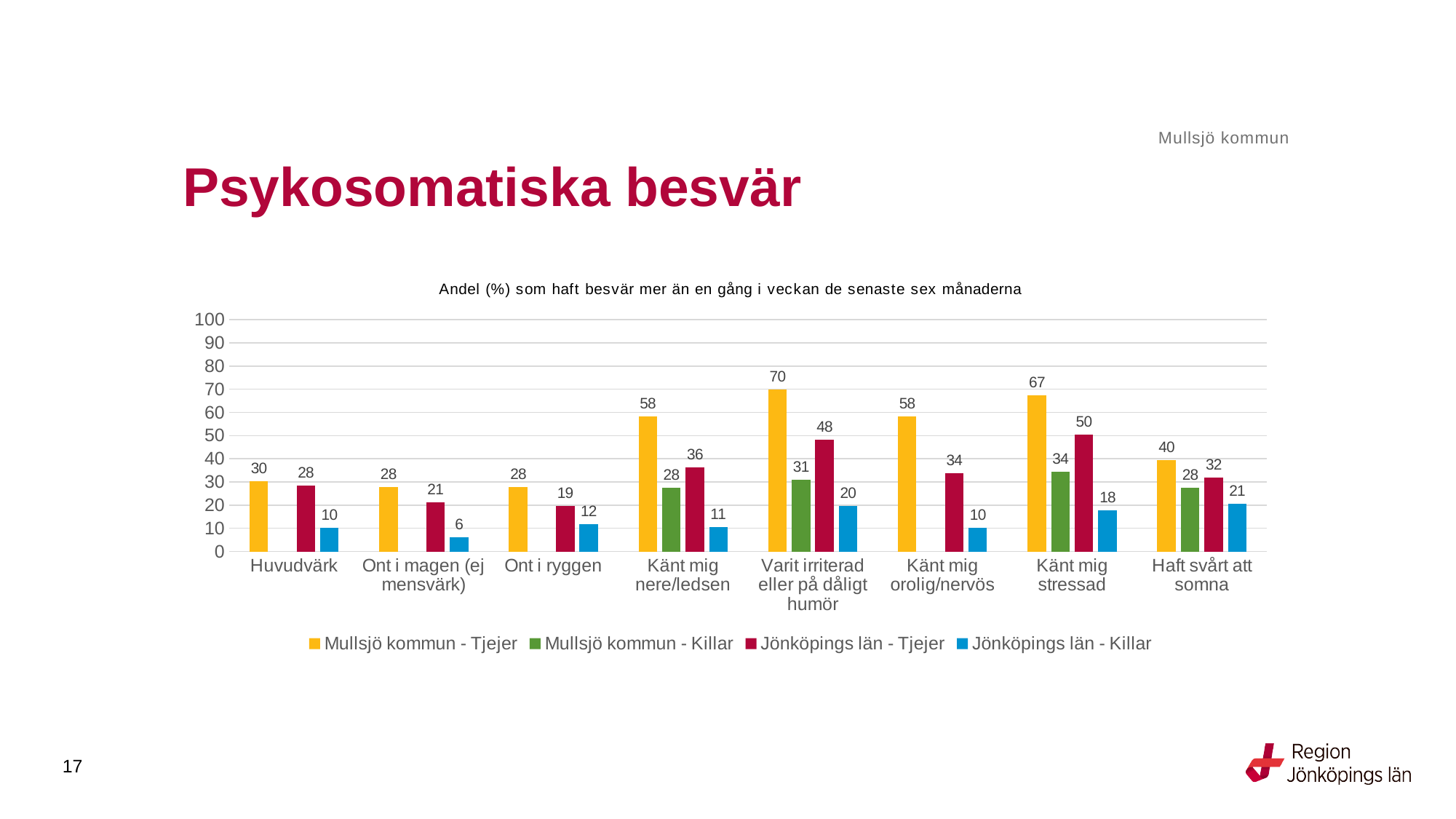
In which category does Mullsjö kommun - Tjejer have its highest value? Varit irriterad eller på dåligt humör What kind of chart is shown on the slide? Bar chart What is the value for Mullsjö kommun - Tjejer in the category 'Varit irriterad eller på dåligt humör'? 70 How many series does the legend list? 4 What is the title of the chart? Andel (%) som haft besvär mer än en gång i veckan de senaste sex månaderna How many categories are shown on the x axis of the chart? 8 What is the value for Jönköpings län - Killar in the category 'Ont i magen (ej mensvärk)'? 6 What is the value for Mullsjö kommun - Killar in the category 'Känt mig stressad'? 34 In which category does Jönköpings län - Killar have its lowest value? Ont i magen (ej mensvärk) What is the value for Jönköpings län - Tjejer in the category 'Haft svårt att somna'? 32 Which is larger in the category 'Känt mig stressad': Mullsjö kommun - Tjejer or Jönköpings län - Tjejer? Mullsjö kommun - Tjejer What is the difference between Mullsjö kommun - Tjejer and Jönköpings län - Tjejer in the category 'Känt mig nere/ledsen'? 22